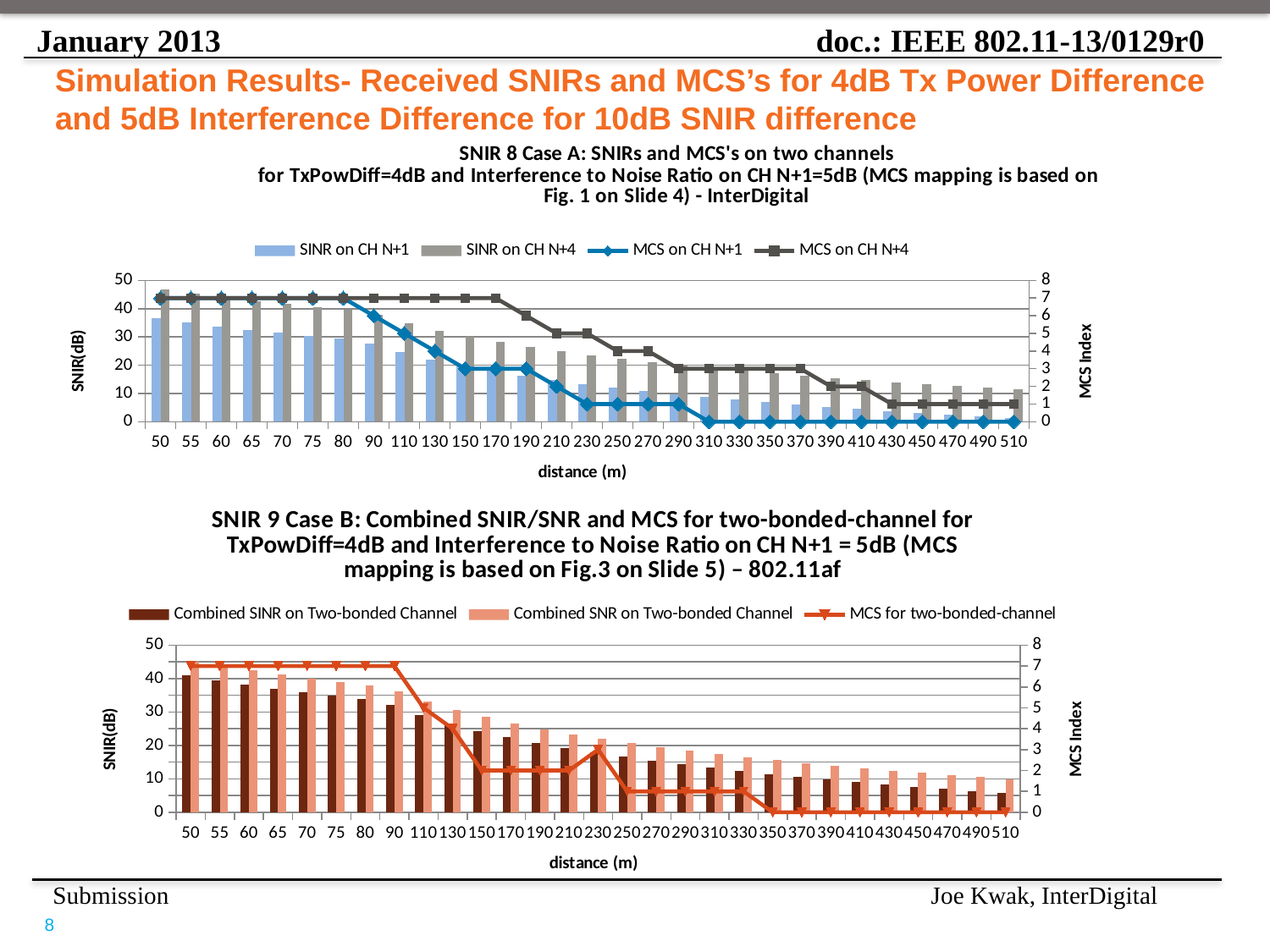
In the bottom chart (SNIR 9 Case B), how many series does the legend list? 3 In the top chart (SNIR 8 Case A), do the SINR on CH N+1 values rise or fall as distance increases? fall In the top chart (SNIR 8 Case A), at 50 m, which is larger: SINR on CH N+1 or SINR on CH N+4? SINR on CH N+4 In the bottom chart (SNIR 9 Case B), at which distance is the Combined SINR on Two-bonded Channel highest? 50 In the bottom chart (SNIR 9 Case B), what is the MCS for two-bonded-channel at a distance of 150 m? 2 In the bottom chart (SNIR 9 Case B), what is the MCS for two-bonded-channel at a distance of 510 m? 0 In the top chart (SNIR 8 Case A), what is the MCS on CH N+1 at a distance of 50 m? 7 In the top chart (SNIR 8 Case A), how many series does the legend list? 4 In the bottom chart (SNIR 9 Case B), is the Combined SINR on Two-bonded Channel at 510 m greater or less than 10? less In the top chart (SNIR 8 Case A), what is the MCS on CH N+4 at a distance of 510 m? 1 What is the label of the x axis on the bottom chart (SNIR 9 Case B)? distance (m) In the top chart (SNIR 8 Case A), is the SINR on CH N+4 at 50 m greater or less than 40? greater